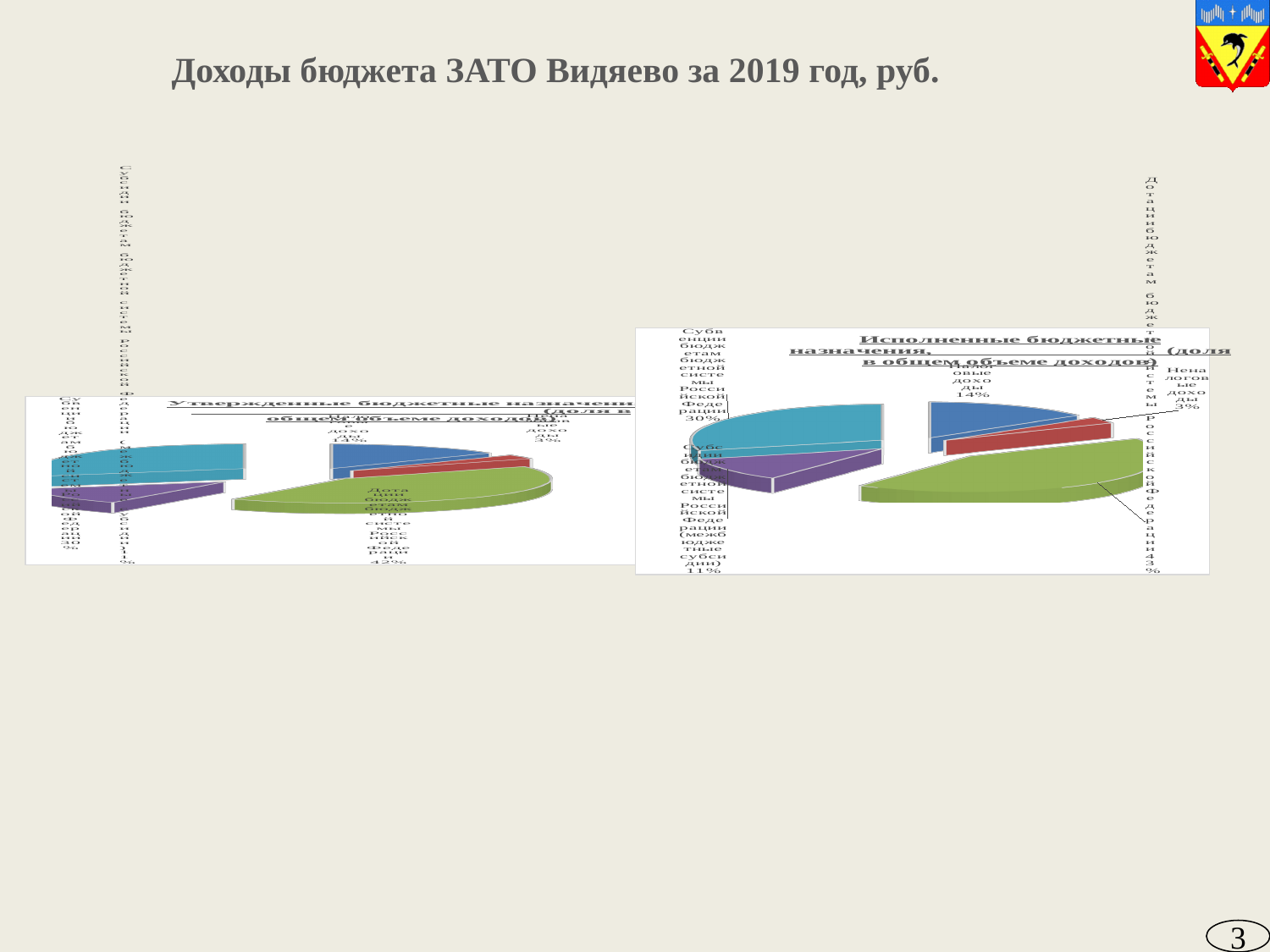
How many slices does the right chart 'Исполненные бюджетные назначения' have? 5 What type of chart is used for the 'Утвержденные бюджетные назначения' chart on the left? pie chart In the left chart 'Утвержденные бюджетные назначения', which category has the smallest share? Неналоговые доходы In the left chart 'Утвержденные бюджетные назначения', what share do Субвенции have? 30% In the left chart 'Утвержденные бюджетные назначения', what share do Дотации (grants) have? 42% Which is larger in the left chart 'Утвержденные бюджетные назначения': the share of Субвенции or the share of Налоговые доходы? Субвенции In the right chart 'Исполненные бюджетные назначения', what is the difference between the shares of Субвенции and Налоговые доходы? 16% In the left chart 'Утвержденные бюджетные назначения', what share do Налоговые доходы (tax revenues) have? 14% In the right chart 'Исполненные бюджетные назначения', which category has the largest share? Дотации бюджетам бюджетной системы Российской Федерации In the right chart 'Исполненные бюджетные назначения', what share do Неналоговые доходы (non-tax revenues) have? 3% In the right chart 'Исполненные бюджетные назначения', what share do Дотации have? 43% In the right chart 'Исполненные бюджетные назначения', what share do Субсидии (межбюджетные субсидии) have? 11%